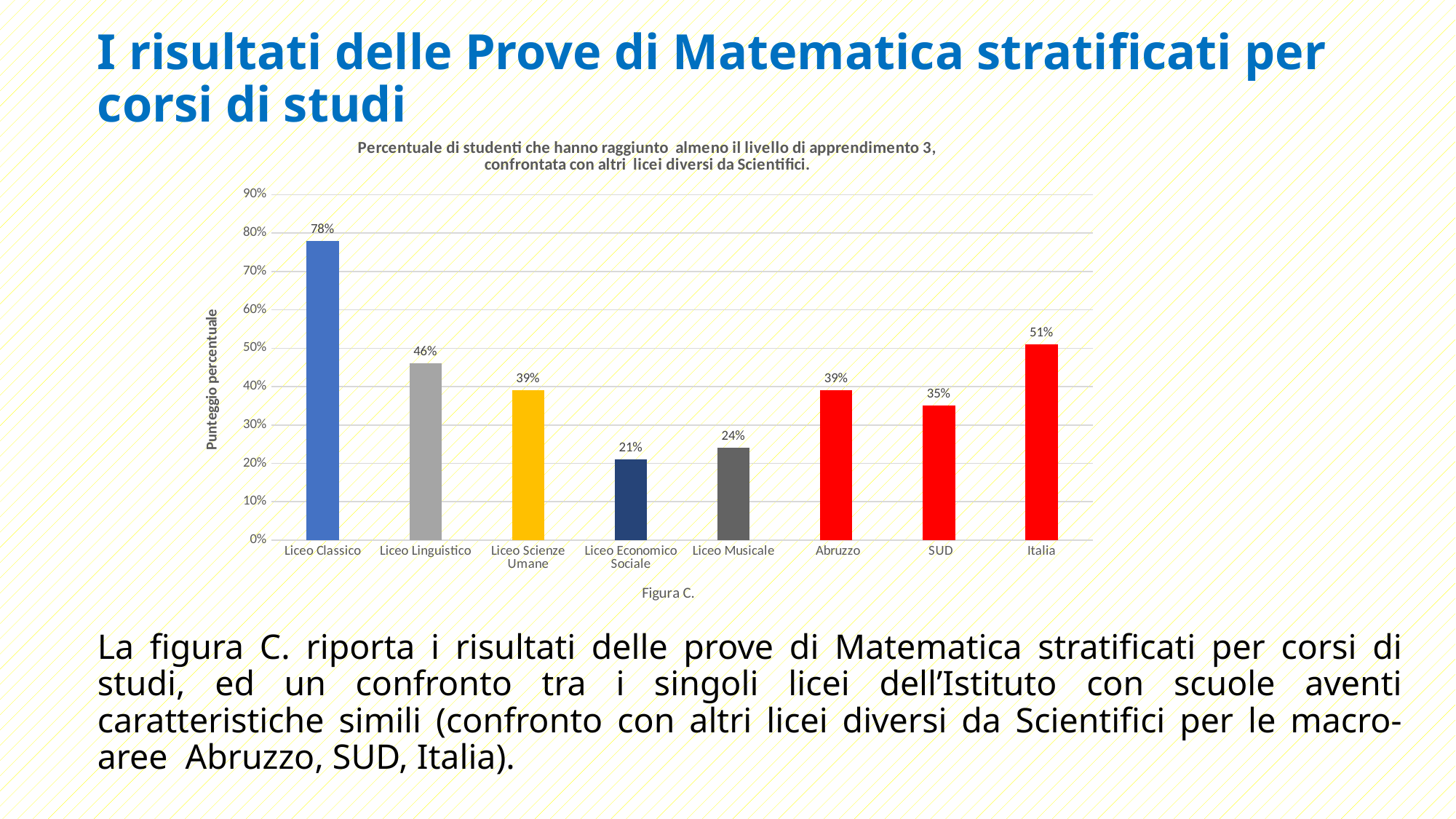
Which category has the highest value? Liceo Classico What is the value for Liceo Classico? 78% Which is larger, the value for Liceo Musicale or the value for Abruzzo? Abruzzo What kind of chart is shown on the slide? bar chart What is the value for SUD? 35% What is the value for Liceo Economico Sociale? 21% How many categories are shown on the x axis? 8 What is the value for Italia? 51% What is the difference between the values for Liceo Classico and Liceo Linguistico? 32% What is the label of the y axis? Punteggio percentuale Is the value for Liceo Linguistico greater or less than 40%? greater Which category has the lowest value? Liceo Economico Sociale